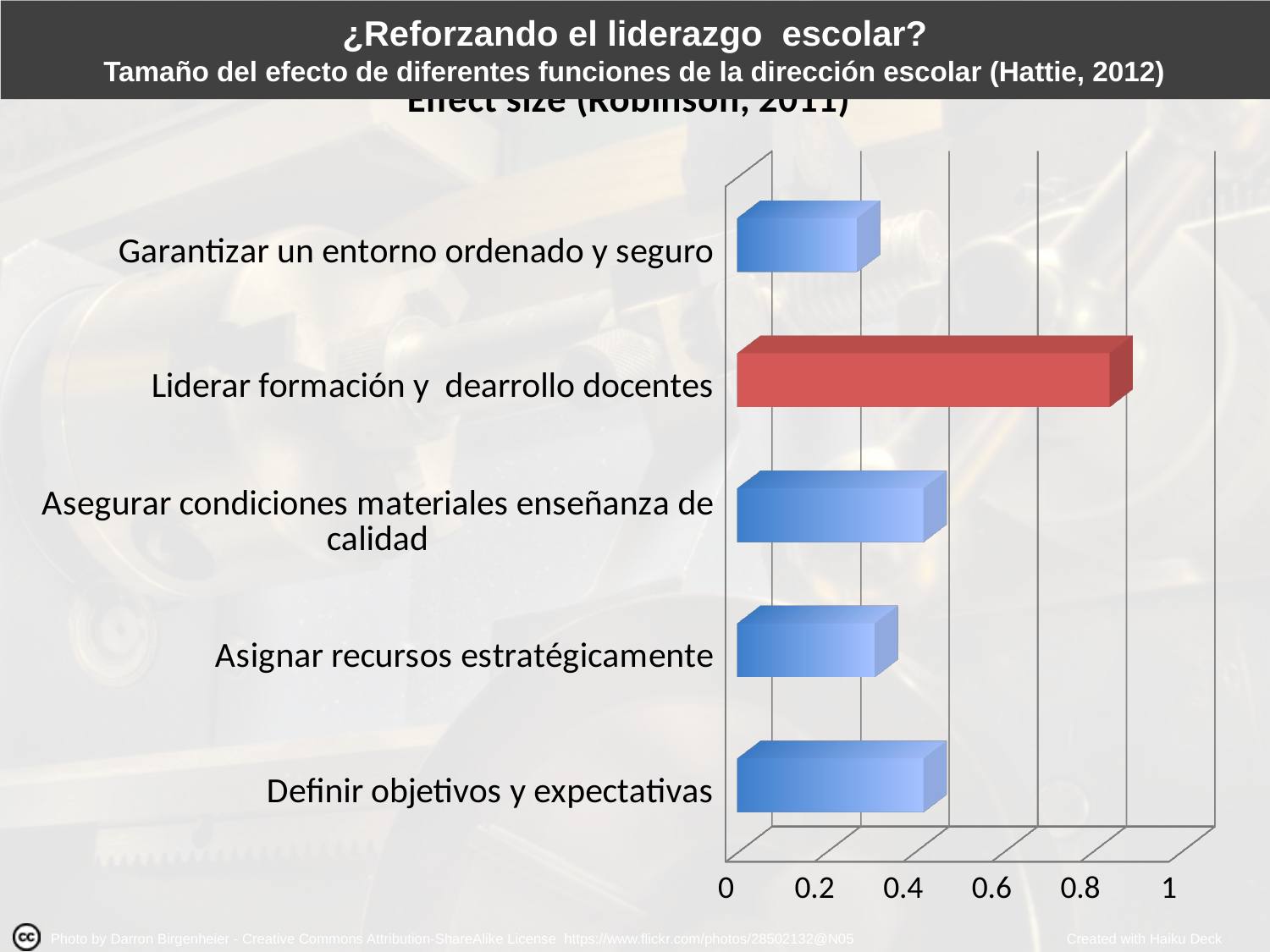
Which category has the highest effect size? Liderar formación y dearrollo docentes Is the value for Liderar formación y dearrollo docentes greater or less than 0.8? greater What is the maximum value shown on the horizontal axis? 1 Which is larger: the value for Liderar formación y dearrollo docentes or for Garantizar un entorno ordenado y seguro? Liderar formación y dearrollo docentes Which is larger: the value for Asegurar condiciones materiales enseñanza de calidad or for Asignar recursos estratégicamente? Asegurar condiciones materiales enseñanza de calidad Is the value for Asegurar condiciones materiales enseñanza de calidad greater or less than 0.6? less Which category's bar is coloured red instead of blue? Liderar formación y dearrollo docentes What kind of chart is shown on the slide? bar chart Is the value for Garantizar un entorno ordenado y seguro greater or less than 0.4? less How many categories (bars) does the chart show? 5